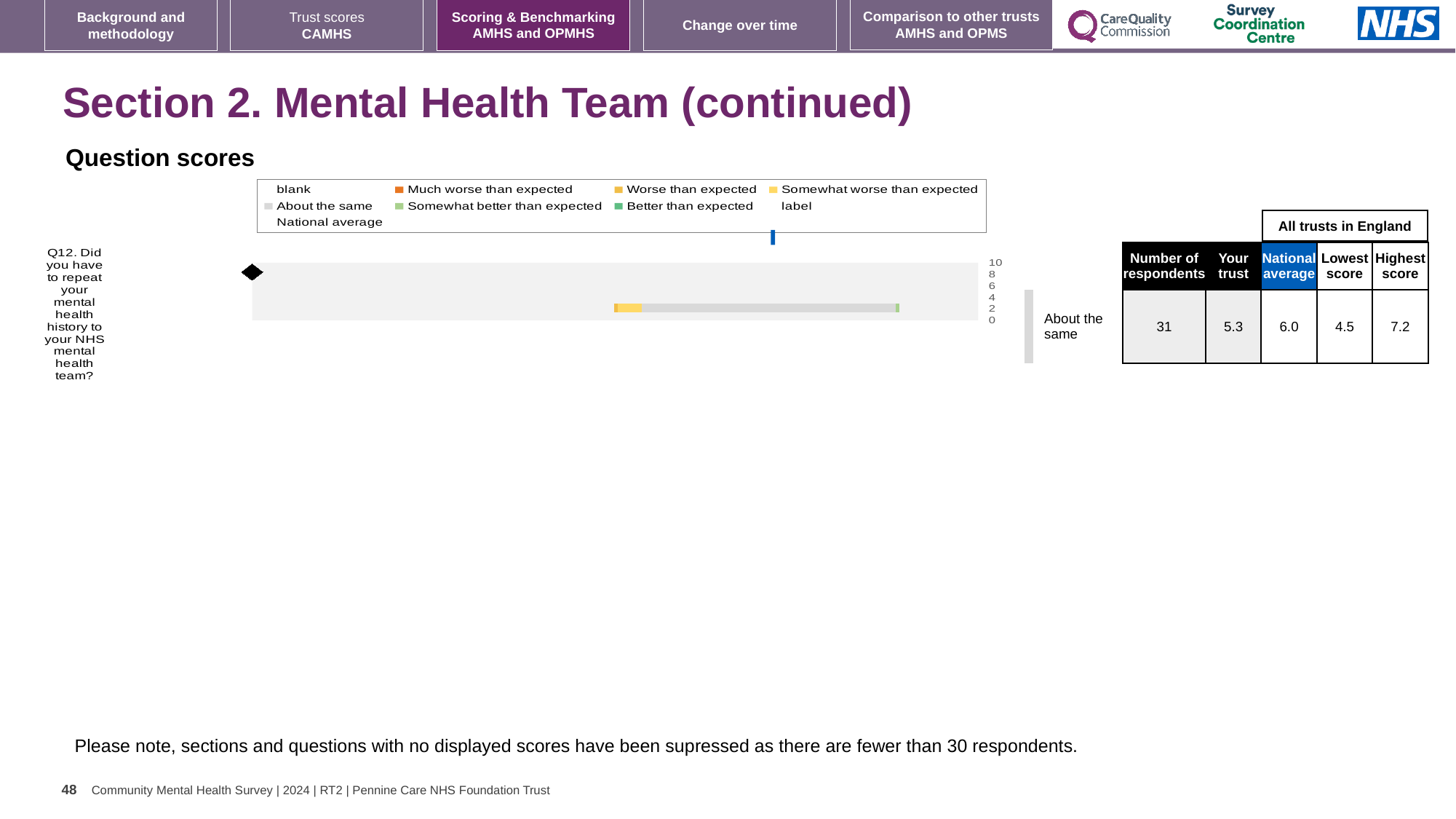
In the table beside the chart, what is the 'Your trust' score for Q12? 5.3 In the table beside the chart, what is the lowest score among all trusts in England for Q12? 4.5 In the table beside the chart, what is the number of respondents for Q12? 31 How many questions are plotted in the Question scores chart? 1 What benchmark category is shown next to the Q12 bar? About the same Which question is plotted in the Question scores chart? Q12. Did you have to repeat your mental health history to your NHS mental health team? For Q12, how much higher is the national average than the 'Your trust' score? 0.7 For Q12, which is larger: the 'Your trust' score or the national average? National average What kind of chart is used to show the Q12 question score? bar chart In the table beside the chart, what is the national average score for Q12? 6.0 In the table beside the chart, what is the highest score among all trusts in England for Q12? 7.2 For Q12, what is the difference between the highest score and the lowest score among all trusts in England? 2.7